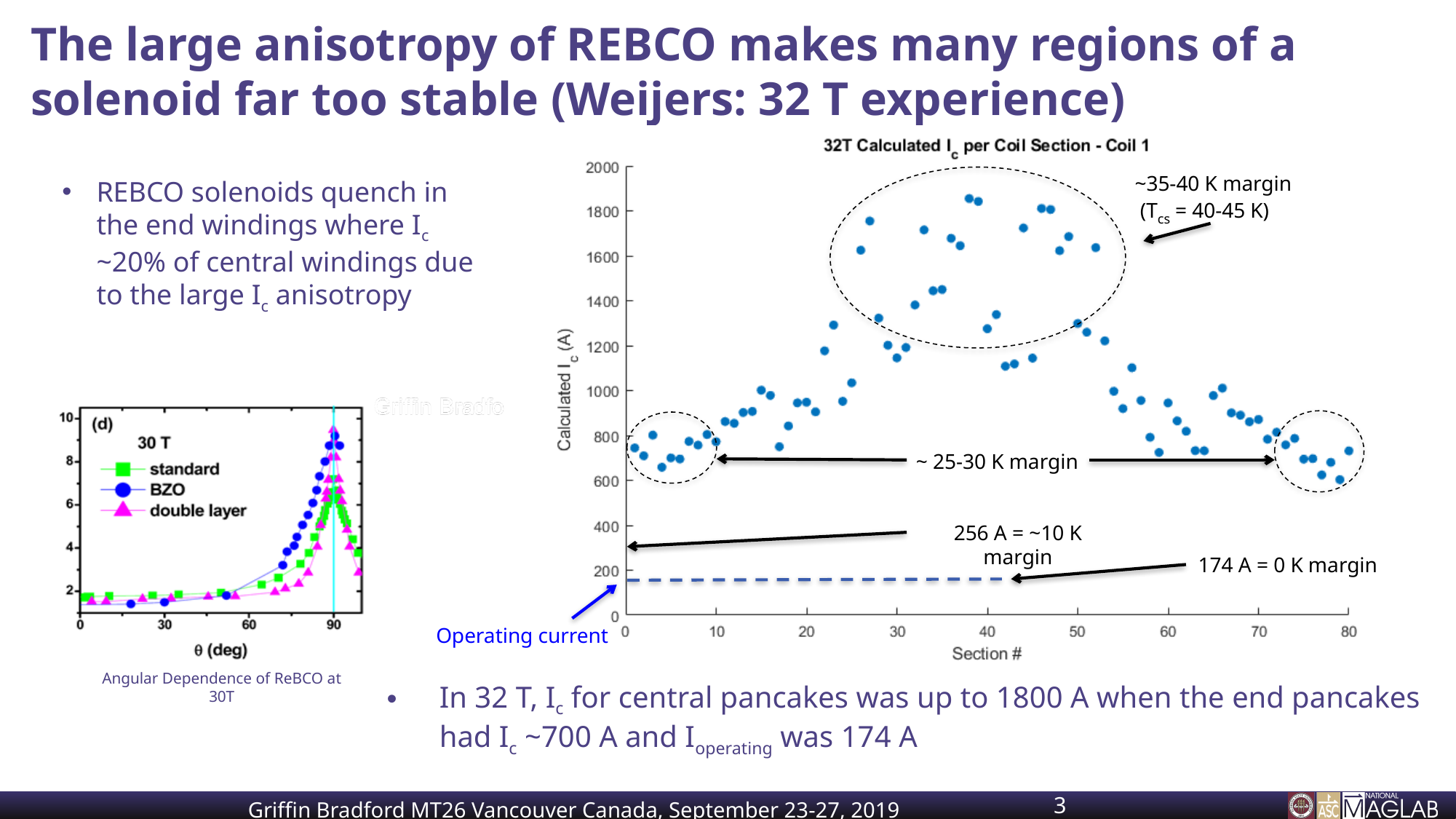
In the large chart on the right, is the highest plotted Ic value greater or less than 1800? greater In the small chart on the left, which series reaches the highest value at 90 degrees? BZO In the large chart on the right, what current corresponds to a ~10 K margin according to the annotation? 256 A What is the title of the large chart on the right? 32T Calculated Ic per Coil Section - Coil 1 In the large chart on the right, what is the label of the x axis? Section # In the large chart on the right, what is the maximum value shown on the y axis? 2000 In the large chart on the right, what temperature margin is annotated for the central sections circled at the top? ~35-40 K margin In the large chart on the right, do the Ic values rise or fall as the section number goes from 40 to 80? fall In the large chart on the right, what current does the dashed horizontal line (operating current) represent? 174 A How many series does the legend of the small chart on the left list? 3 In the large chart on the right, are the Ic values for sections 1 to 10 greater or less than 1000? less In the small chart on the left, do the values rise or fall as θ goes from 0 to 90 degrees? rise